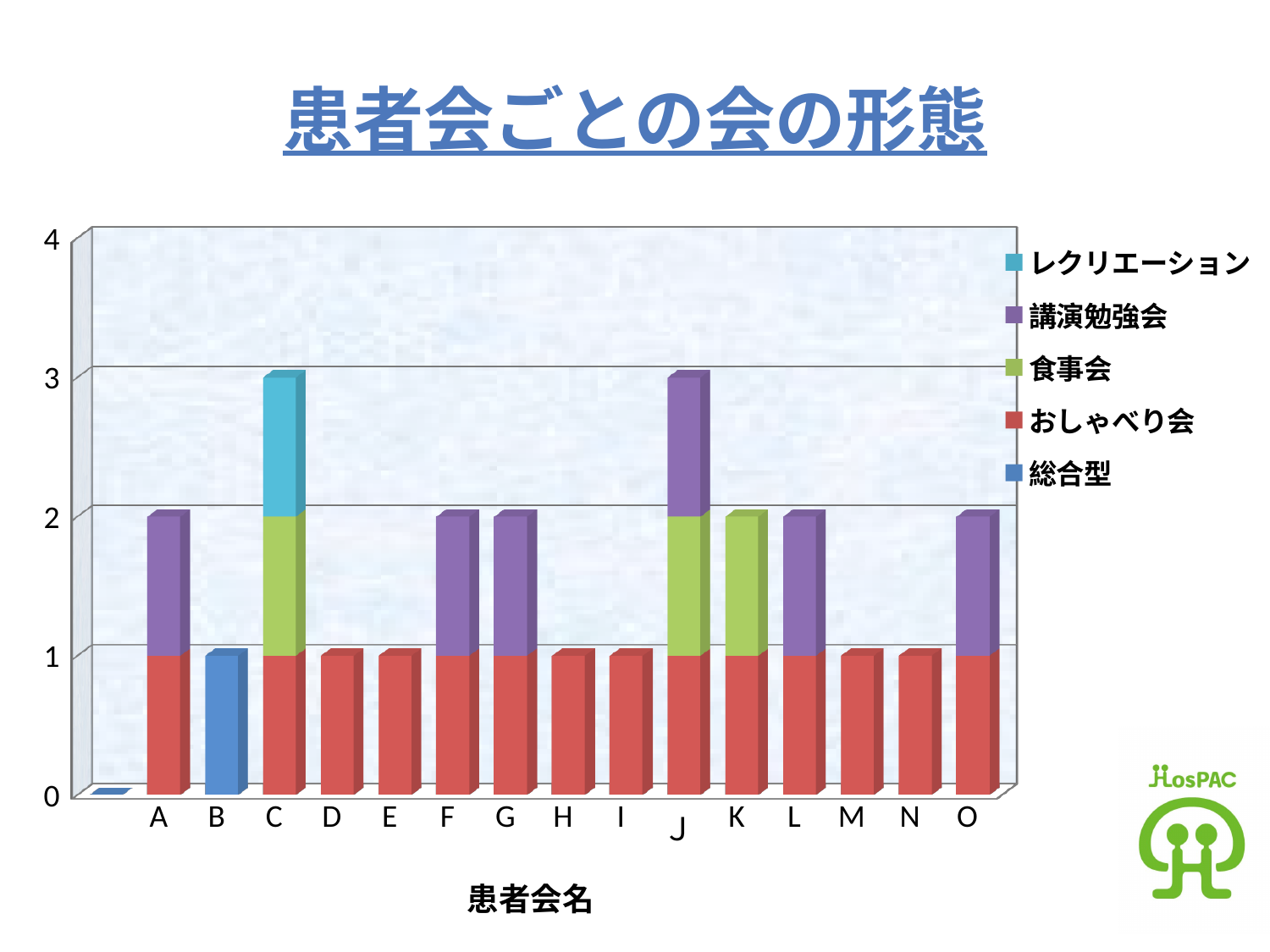
What kind of chart is shown on the slide? bar chart What is the difference between the total for patient group C and the total for patient group B? 2 What is the value of おしゃべり会 for patient group D? 1 What is the total height of the stacked bar for patient group A? 2 What is the title of the chart? 患者会ごとの会の形態 What is the total height of the stacked bar for patient group C? 3 Which has the taller stacked bar, patient group C or patient group D? C How many patient groups (A to O) are labeled on the x axis? 15 What is the value of 総合型 for patient group B? 1 How many series does the legend list? 5 Is the total for patient group K greater or less than 1? greater What is the total height of the stacked bar for patient group J? 3